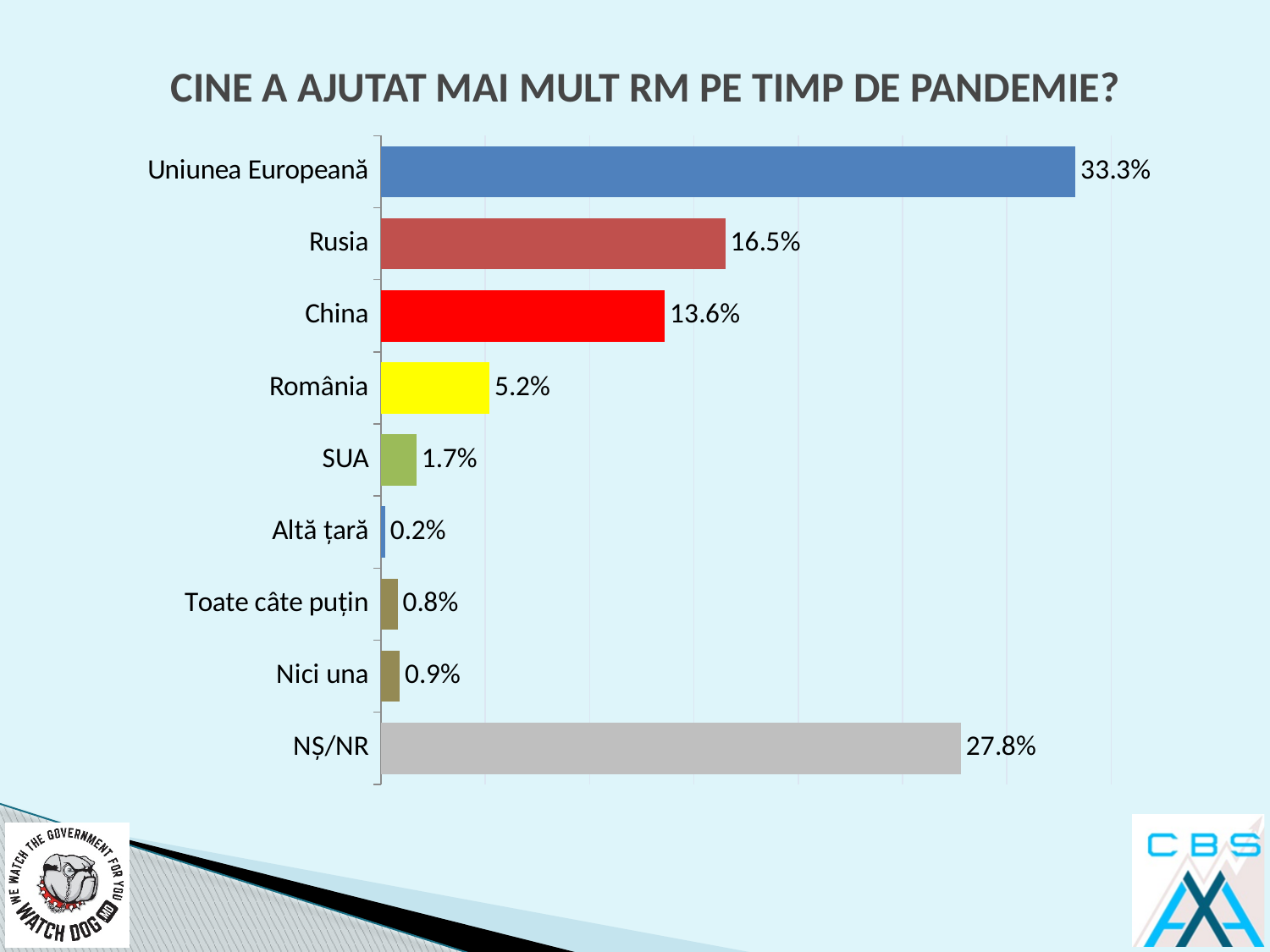
What is the difference between the values for Rusia and China? 2.9% Which category has the highest value? Uniunea Europeană What is the value for NȘ/NR? 27.8% Which is larger, the value for România or the value for SUA? România What is the value for Rusia? 16.5% What is the title of the chart? CINE A AJUTAT MAI MULT RM PE TIMP DE PANDEMIE? What is the value for China? 13.6% What is the value for Uniunea Europeană? 33.3% What kind of chart is shown on the slide? Bar chart What is the difference between the values for Uniunea Europeană and Rusia? 16.8% Which category has the lowest value? Altă țară How many categories are shown in the chart? 9